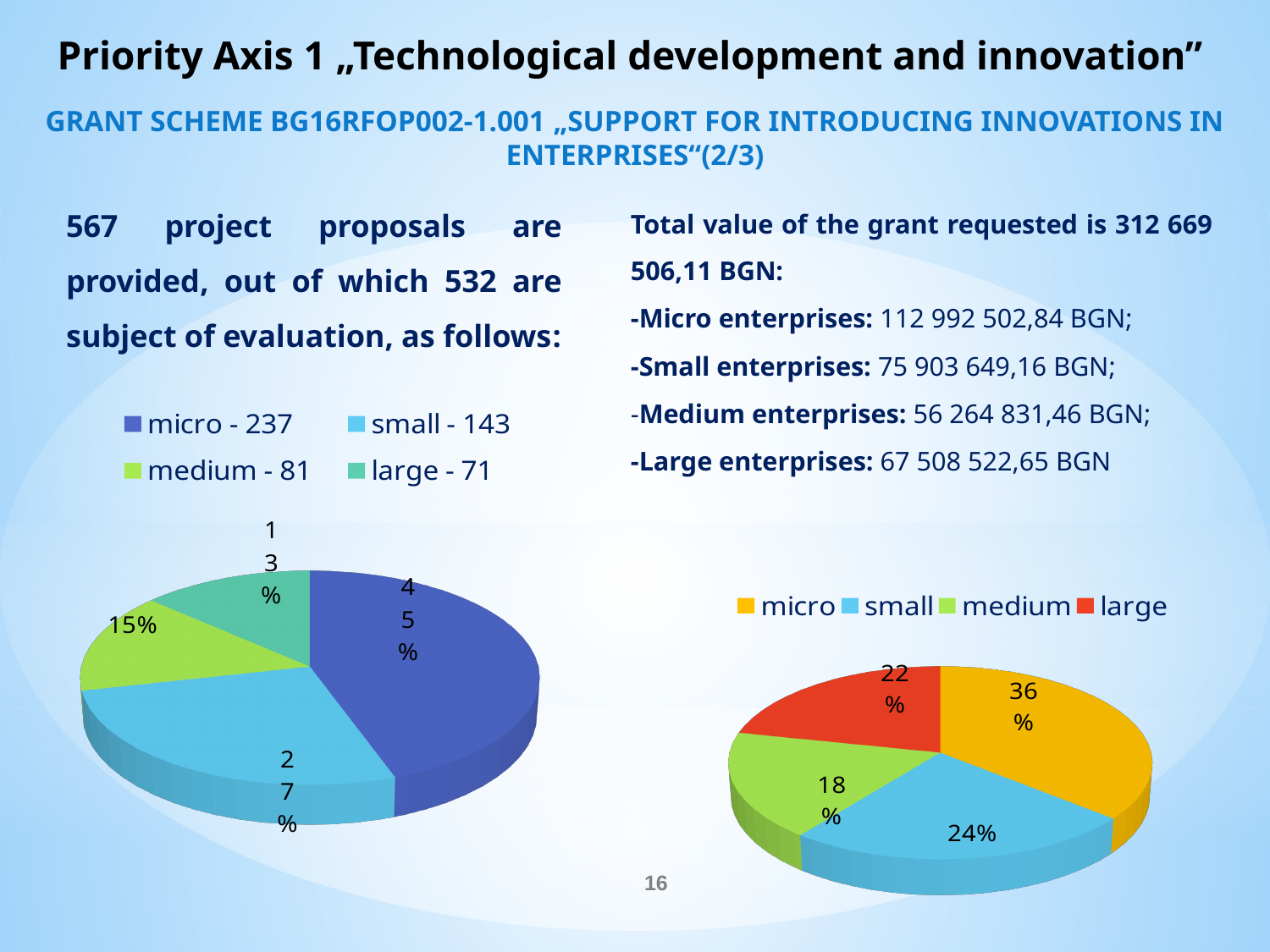
In the left pie chart, which category has the largest slice? micro How many categories does the legend of the right pie chart list? 4 In the left pie chart, what percentage share does the micro slice have? 45% What type of chart is shown on the left side of the slide? pie chart In the left pie chart, what percentage share does the large slice have? 13% In the left pie chart, what percentage share does the small slice have? 27% In the right pie chart, which category has the smallest slice? medium In the right pie chart, what is the difference in percentage points between the micro and small slices? 12 In the left pie chart, how many project proposals does the legend give for small enterprises? 143